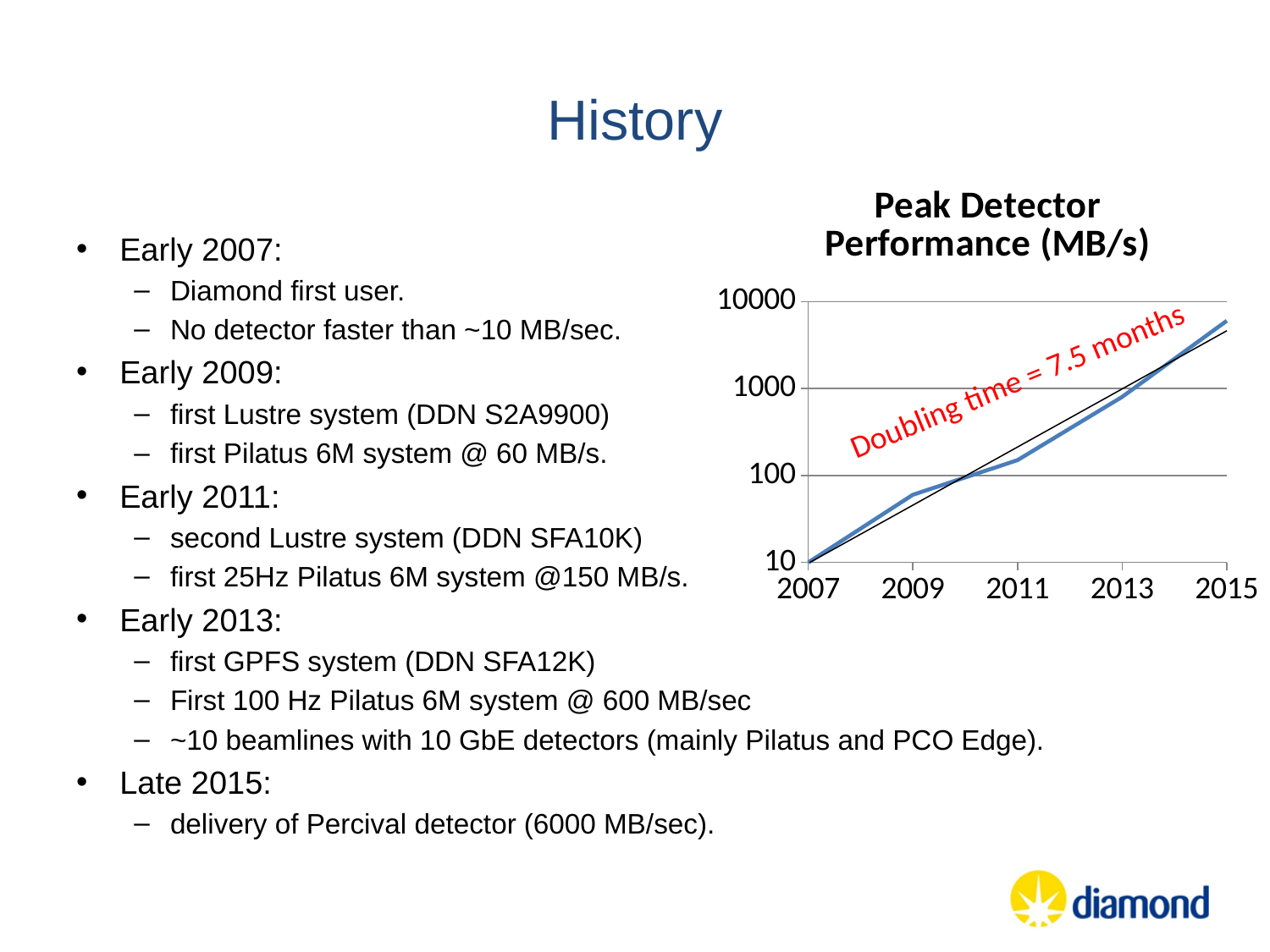
Is the peak detector performance in 2015 greater or less than 10000? less What doubling time is annotated on the chart? 7.5 months Does the peak detector performance rise or fall from 2007 to 2015? rise What is the title of the chart? Peak Detector Performance (MB/s) Is the peak detector performance in 2015 greater or less than 1000? greater Is the peak detector performance in 2013 greater or less than 1000? less What kind of chart is shown on the slide? line chart How many year labels are shown on the x axis of the chart? 5 Which year shown on the x axis has the lowest peak detector performance? 2007 Which year shown on the x axis has the highest peak detector performance? 2015